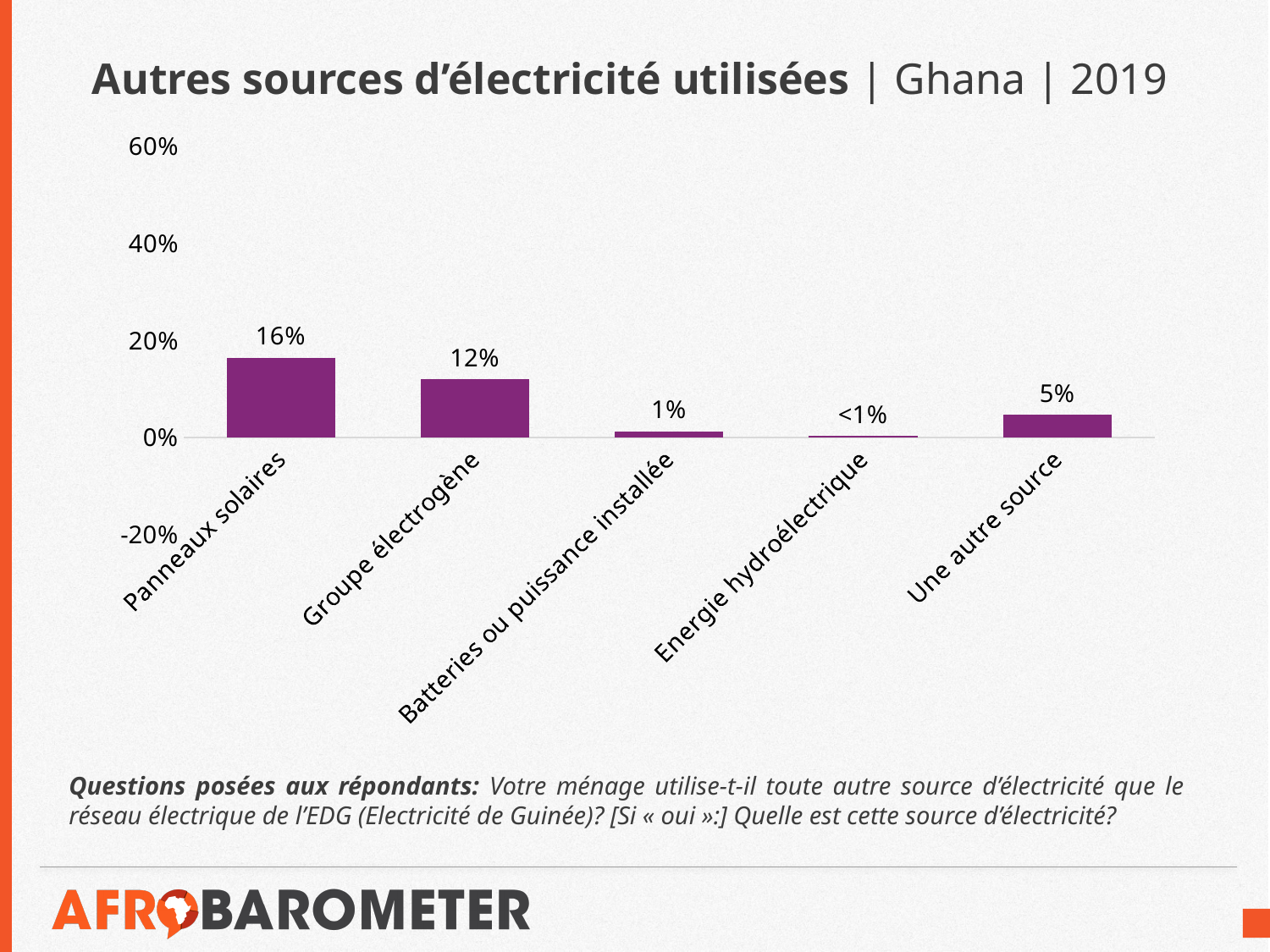
What kind of chart is shown on the slide? bar chart What is the value for Groupe électrogène? 12% Which is larger, the value for Groupe électrogène or the value for Une autre source? Groupe électrogène How many categories are shown on the chart? 5 What is the value for Panneaux solaires? 16% What is the difference between the values for Panneaux solaires and Groupe électrogène? 4% Which category has the highest value? Panneaux solaires What is the value shown for Energie hydroélectrique? <1% Is the value for Panneaux solaires greater or less than 20%? less Which category has the lowest value? Energie hydroélectrique What is the value for Batteries ou puissance installée? 1% What is the value for Une autre source? 5%